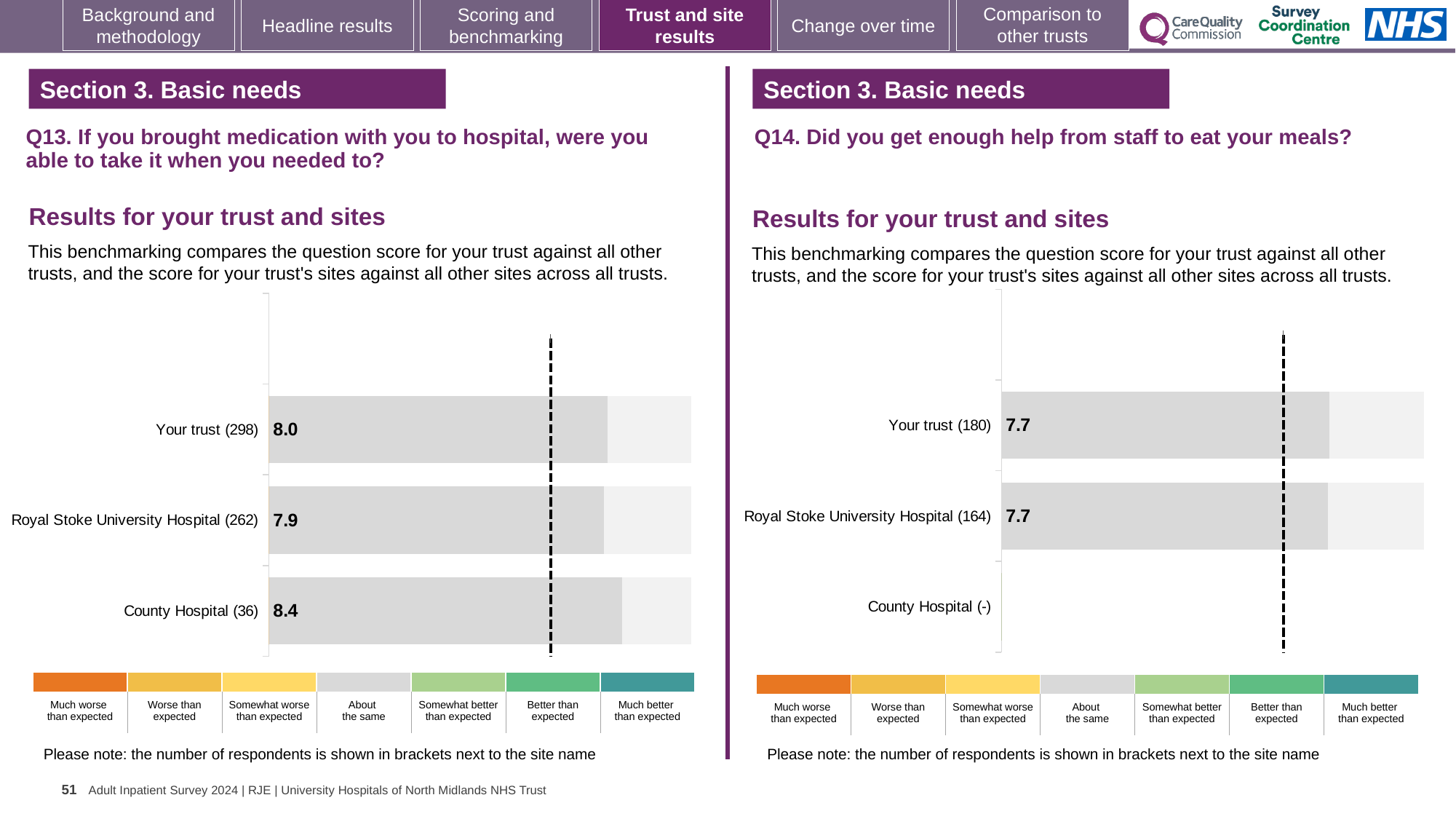
How many categories (rows) are listed in the Q13 chart on the left? 3 In the Q13 chart on the left, what is the difference between the County Hospital score and the Royal Stoke University Hospital score? 0.5 In the Q13 chart on the left, what is the score for Your trust? 8.0 In the Q14 chart on the right, what is the score for Your trust? 7.7 In the Q13 chart on the left, how many respondents are shown for County Hospital? 36 In the Q13 chart on the left, what is the score for Royal Stoke University Hospital? 7.9 In the Q14 chart on the right, what is the score for Royal Stoke University Hospital? 7.7 In the Q13 chart on the left, which site or trust has the highest score? County Hospital In the Q13 chart on the left, which site or trust has the lowest score? Royal Stoke University Hospital In the Q14 chart on the right, how many respondents are shown for Your trust? 180 What kind of chart is used in the Q14 chart on the right? Bar chart In the Q13 chart on the left, what is the score for County Hospital? 8.4